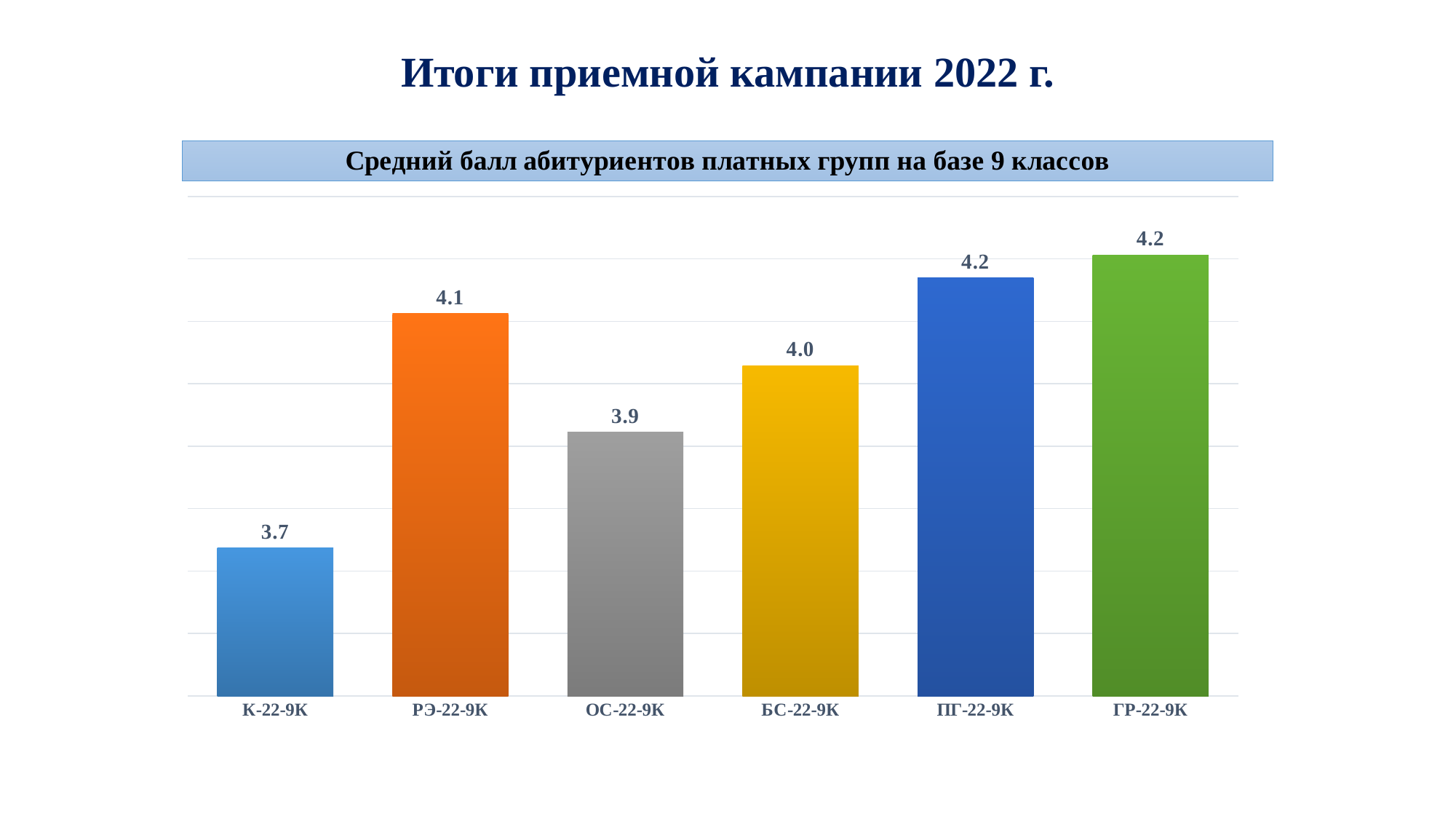
What is the average score for РЭ-22-9К? 4.1 What type of chart is shown on the slide? Bar chart What is the difference between the average scores of РЭ-22-9К and ОС-22-9К? 0.2 How many groups are shown in the chart? 6 What is the average score for К-22-9К? 3.7 Which group has the lowest average score? К-22-9К What is the average score for БС-22-9К? 4.0 What is the average score for ОС-22-9К? 3.9 What is the average score for ПГ-22-9К? 4.2 What is the difference between the average scores of ГР-22-9К and К-22-9К? 0.5 What is the title of the chart? Средний балл абитуриентов платных групп на базе 9 классов Which has a higher average score, РЭ-22-9К or БС-22-9К? РЭ-22-9К